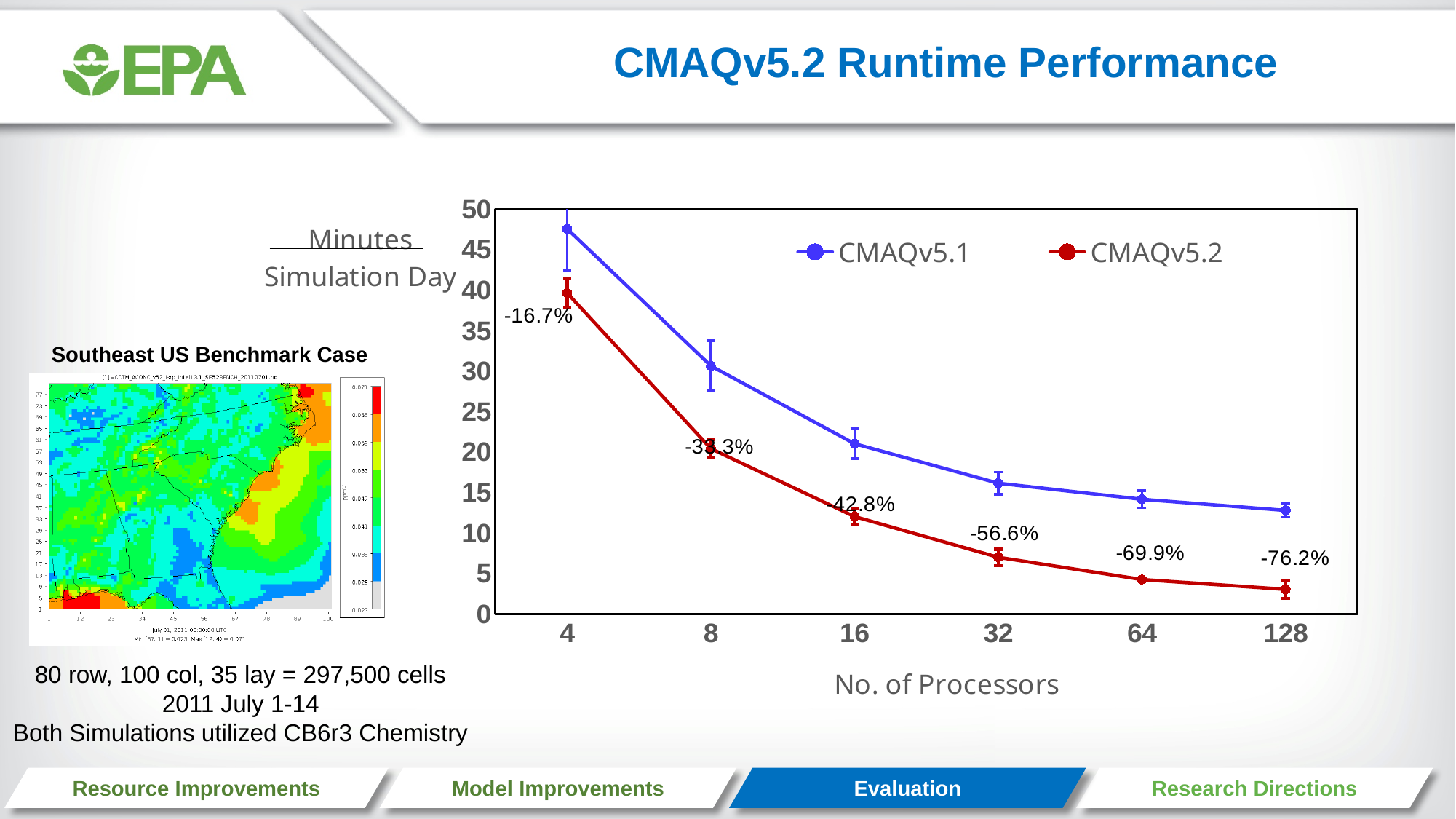
At 16 processors, which series has the higher value, CMAQv5.1 or CMAQv5.2? CMAQv5.1 How many processor counts are plotted along the x axis? 6 Is the CMAQv5.1 value at 4 processors greater or less than 45? greater What percentage change is labelled at 128 processors? -76.2% How many series does the chart legend list? 2 Is the CMAQv5.2 value at 128 processors greater or less than 5? less Do the values rise or fall as the number of processors increases? fall What percentage change is labelled at 32 processors? -56.6% What kind of chart is shown on the slide? line chart What percentage change is labelled at 16 processors? -42.8% What percentage change is labelled at 4 processors? -16.7% What percentage change is labelled at 64 processors? -69.9%